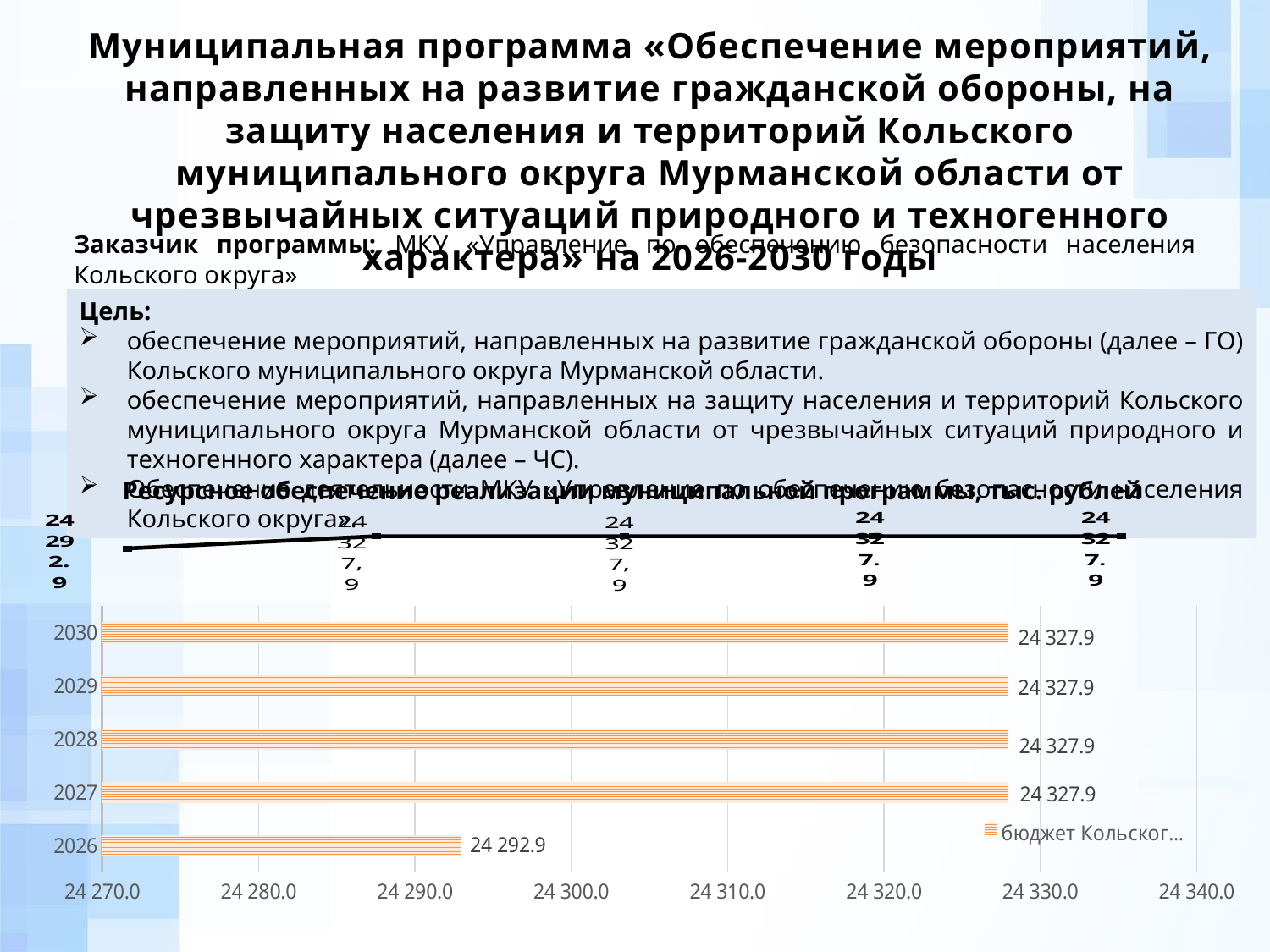
Is the value for 2028 in the bar chart greater or less than 24 320.0? greater What kind of chart is used to show the values by year? bar chart What is the difference between the values for 2030 and 2026 in the bar chart? 35.0 What is the value for 2028 in the bar chart? 24 327.9 Which year has the lowest value in the bar chart? 2026 In what units are the values of the chart expressed, according to its title? тыс. рублей Do the values in the bar chart rise or fall from 2026 to 2030? rise What is the value for 2030 in the bar chart? 24 327.9 Which is larger in the bar chart, the value for 2027 or the value for 2026? 2027 How many years are shown in the bar chart? 5 Is the value for 2026 in the bar chart greater or less than 24 300.0? less What is the value for 2026 in the bar chart? 24 292.9